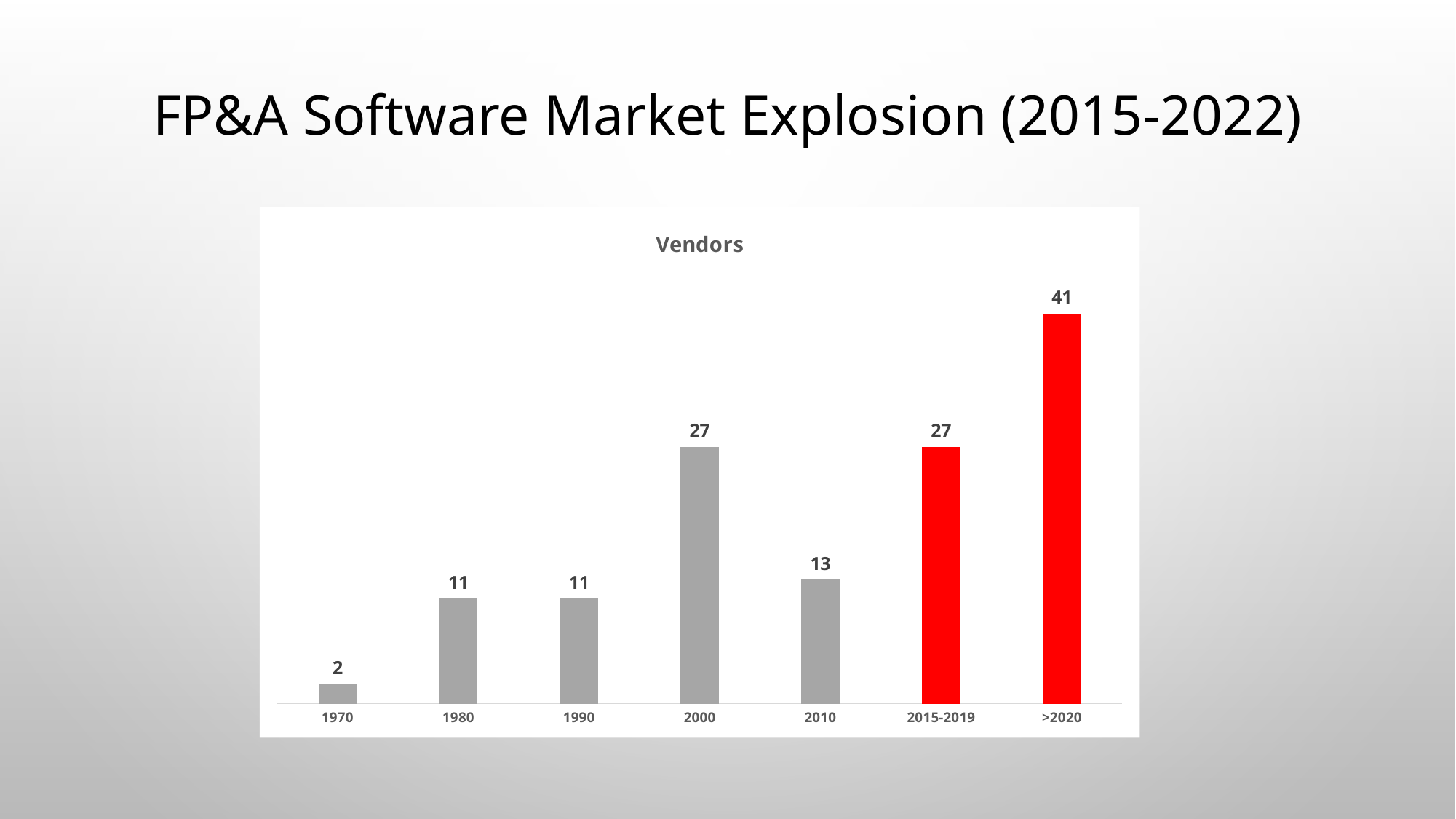
What is the value for 1970? 2 What is the value for >2020? 41 What is the difference between the values for 2000 and 2010? 14 What is the title of the chart? Vendors What kind of chart is shown on the slide? bar chart How many categories are shown on the x axis? 7 Which category has the lowest value? 1970 Which is larger, the value for 2010 or the value for 1990? 2010 Which category has the highest value? >2020 What is the value for 2000? 27 What is the value for 2010? 13 What is the difference between the values for >2020 and 2015-2019? 14